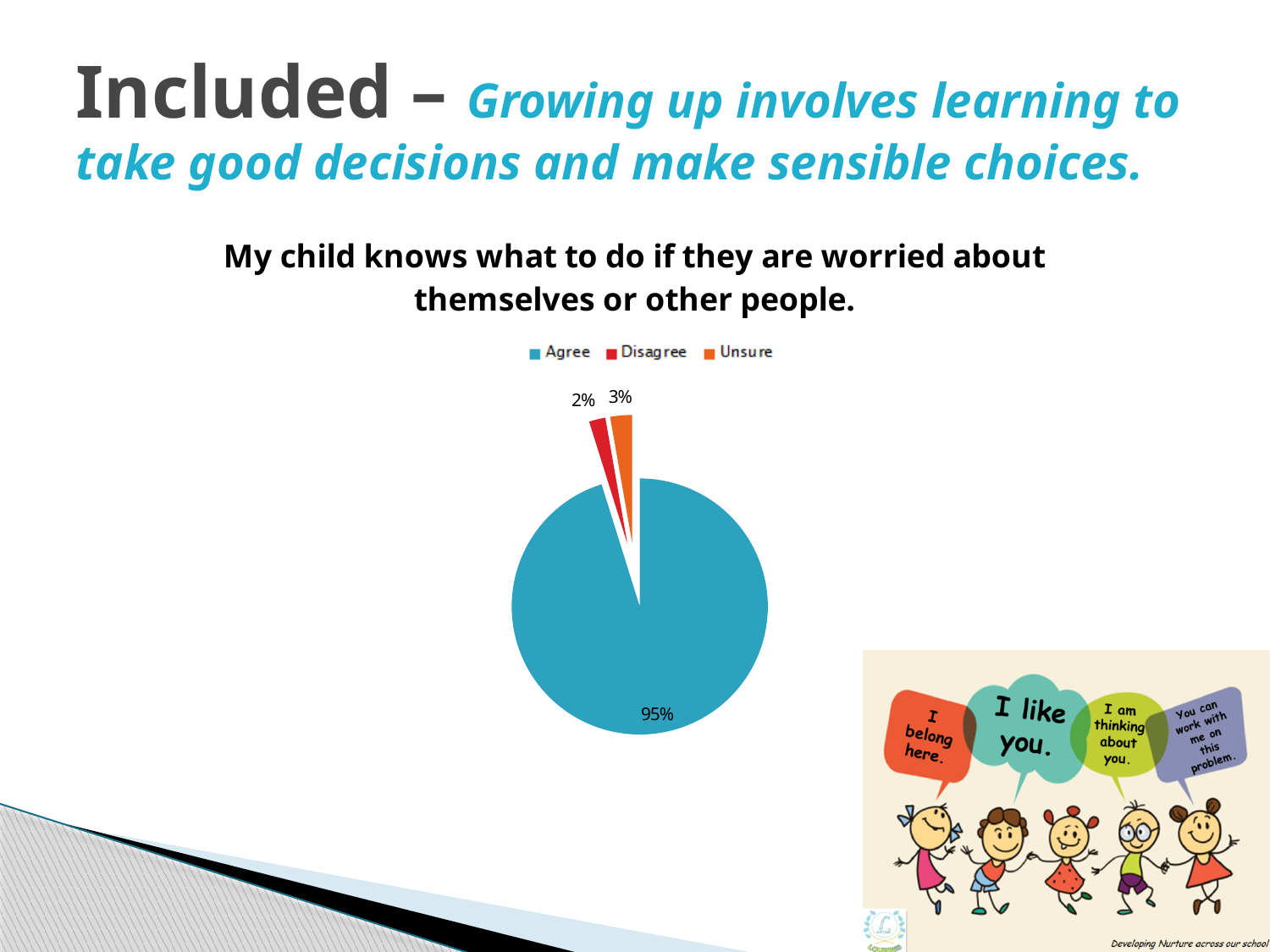
Which response has the largest share of the pie? Agree What colour represents Agree in the pie chart? teal/blue What percentage of respondents chose Agree? 95% What kind of chart is shown on the slide? pie chart What percentage of respondents chose Unsure? 3% Which is larger, the Unsure share or the Disagree share? Unsure What percentage of respondents chose Disagree? 2% What is the difference between the Agree share and the Unsure share? 92% What is the combined share of Disagree and Unsure? 5% How many categories does the legend list? 3 Which response has the smallest share of the pie? Disagree How many slices does the pie chart have? 3